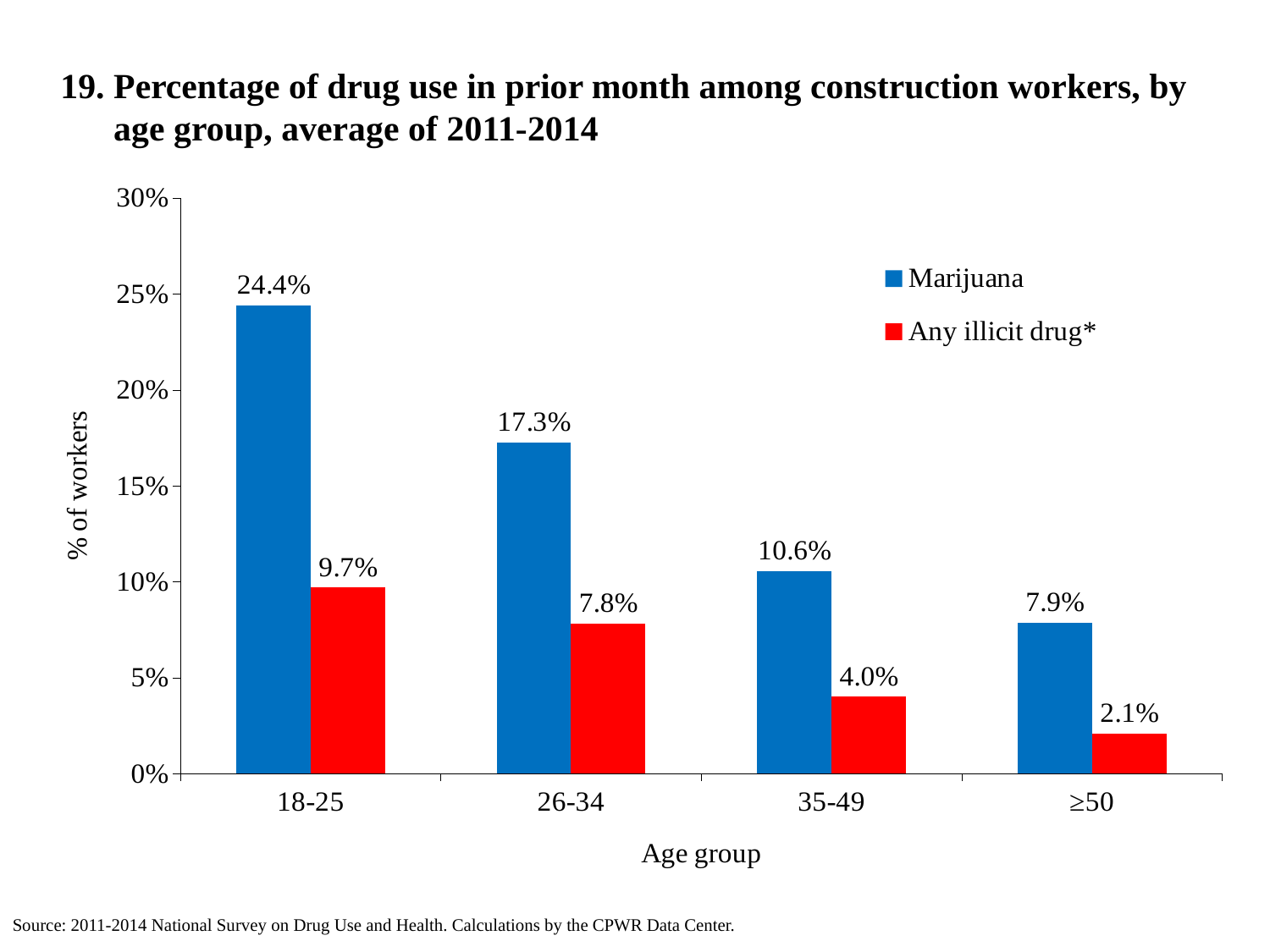
Which age group has the highest Marijuana value? 18-25 Which age group has the lowest Any illicit drug* value? ≥50 What is the Any illicit drug* value for the 35-49 age group? 4.0% Which is larger: the Marijuana value for 35-49 or the Any illicit drug* value for 18-25? Marijuana value for 35-49 Do the Marijuana values rise or fall as age group increases along the x axis? Fall What is the difference between the Marijuana and Any illicit drug* values for the 26-34 age group? 9.5% What is the Marijuana value for the 18-25 age group? 24.4% How many series does the legend list? 2 What kind of chart is shown on the slide? Bar chart What is the Marijuana value for the ≥50 age group? 7.9% Is the Marijuana value for the 26-34 age group greater or less than 15%? greater How many age groups are shown on the x axis? 4